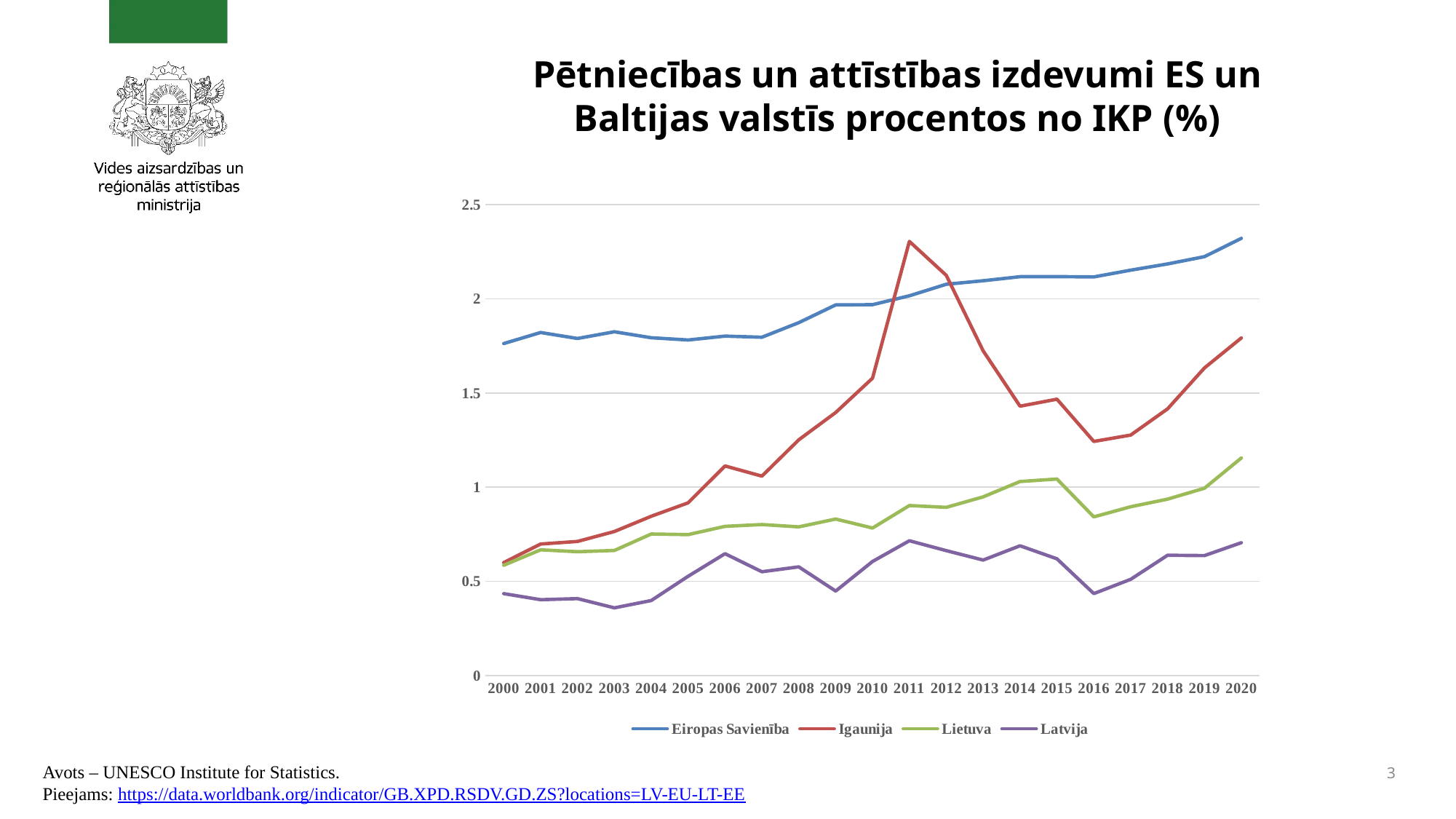
How many series does the legend list? 4 What kind of chart is shown on the slide? line chart In 2016, which is higher: Lietuva or Latvija? Lietuva Is the value for Igaunija in 2011 greater or less than 2? greater Is the value for Lietuva in 2020 greater or less than 1? greater How many years are shown on the x axis? 21 Which series has the lowest value in 2020? Latvija Is the value for Latvija in 2003 greater or less than 0.5? less Which series has the highest value in 2020? Eiropas Savienība In 2011, which is higher: Igaunija or Eiropas Savienība? Igaunija Does the Eiropas Savienība line generally rise or fall from 2000 to 2020? rise